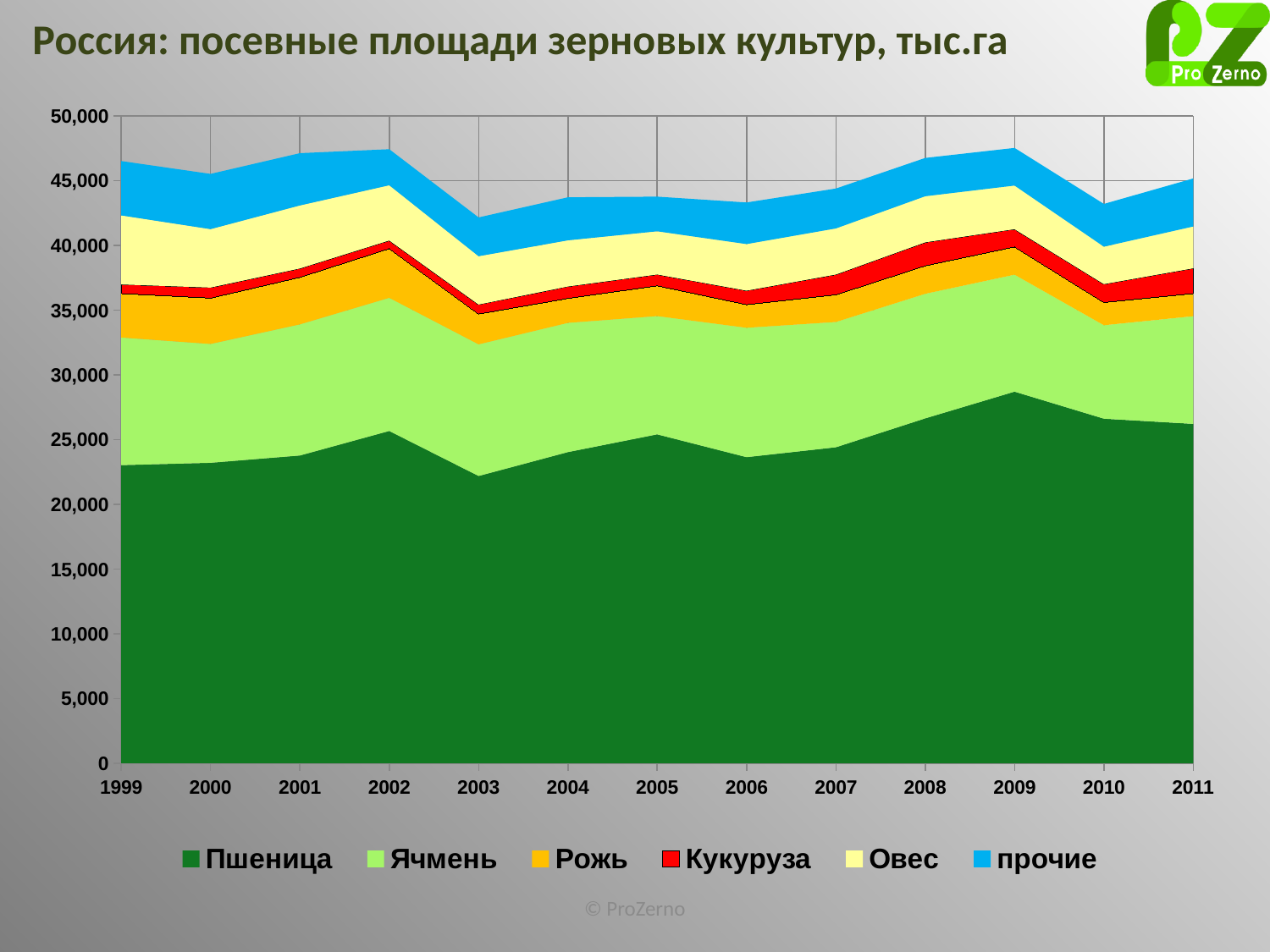
What kind of chart is shown on the slide? stacked area chart How many series does the legend list? 6 Is the value for Пшеница in 2003 greater or less than 25,000? less In which year is the area for Пшеница the highest? 2009 Is the value for Пшеница in 2009 greater or less than 25,000? greater Is the total sown area (top of the stack) in 2002 greater or less than 45,000? greater How many years are plotted along the x axis? 13 What is the title of the chart? Россия: посевные площади зерновых культур, тыс.га Which is larger, the value for Пшеница in 2009 or in 2003? 2009 Which series is shown in dark green at the bottom of the stack? Пшеница In which year is the area for Пшеница the lowest? 2003